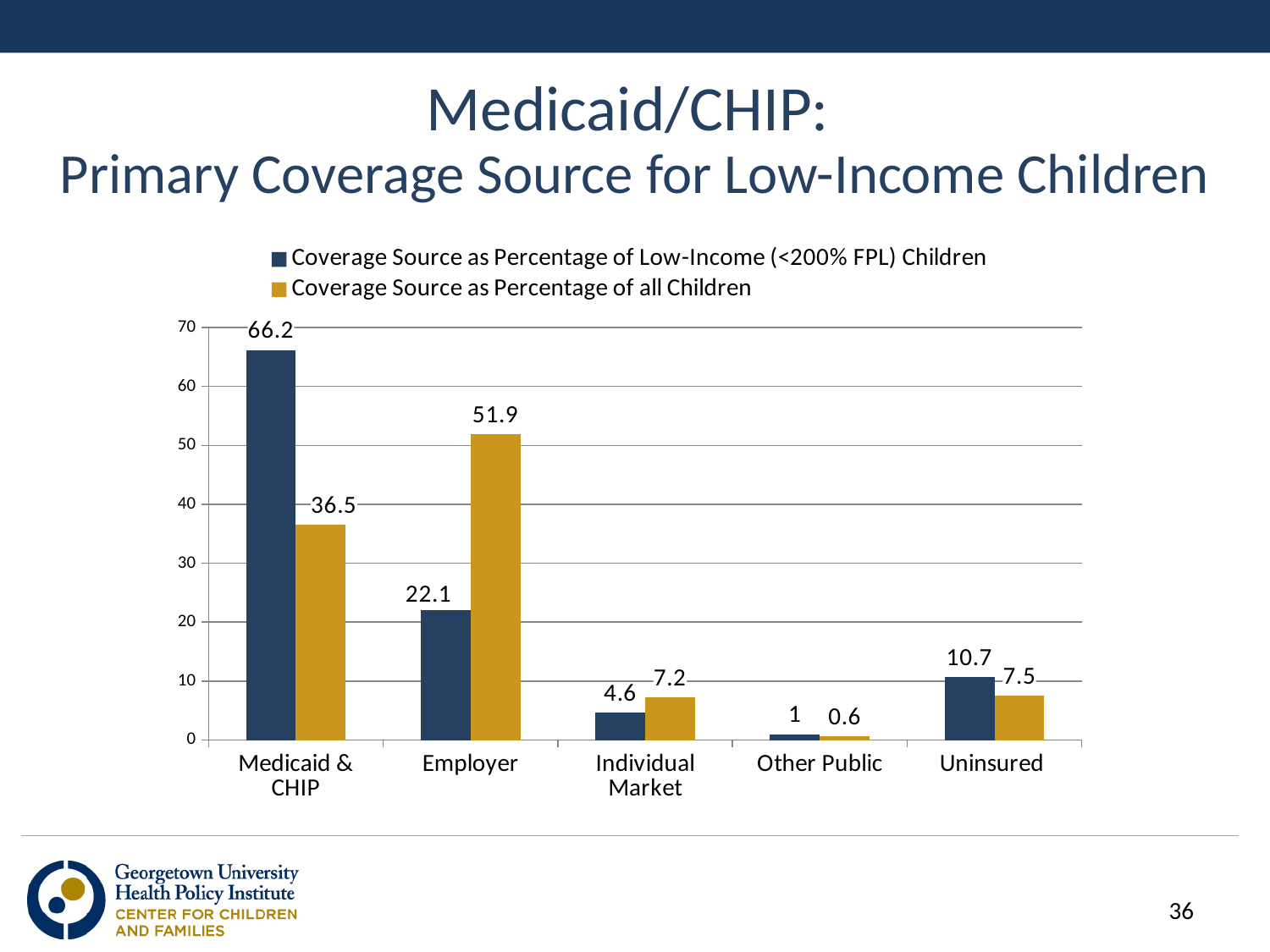
What is the value for Employer in the Coverage Source as Percentage of all Children series? 51.9 For Employer, which series has the larger value? Coverage Source as Percentage of all Children What colour are the bars for the Coverage Source as Percentage of all Children series? Gold What is the value for Other Public in the Coverage Source as Percentage of all Children series? 0.6 How many series does the legend list? 2 What is the value for Uninsured in the Coverage Source as Percentage of Low-Income (<200% FPL) Children series? 10.7 What is the difference between the two series' values for Medicaid & CHIP? 29.7 Which category has the lowest value in the Coverage Source as Percentage of Low-Income (<200% FPL) Children series? Other Public What is the value for Medicaid & CHIP in the Coverage Source as Percentage of Low-Income (<200% FPL) Children series? 66.2 What kind of chart is shown on the slide? Bar chart How many categories are shown on the x axis? 5 Which category has the highest value in the Coverage Source as Percentage of all Children series? Employer